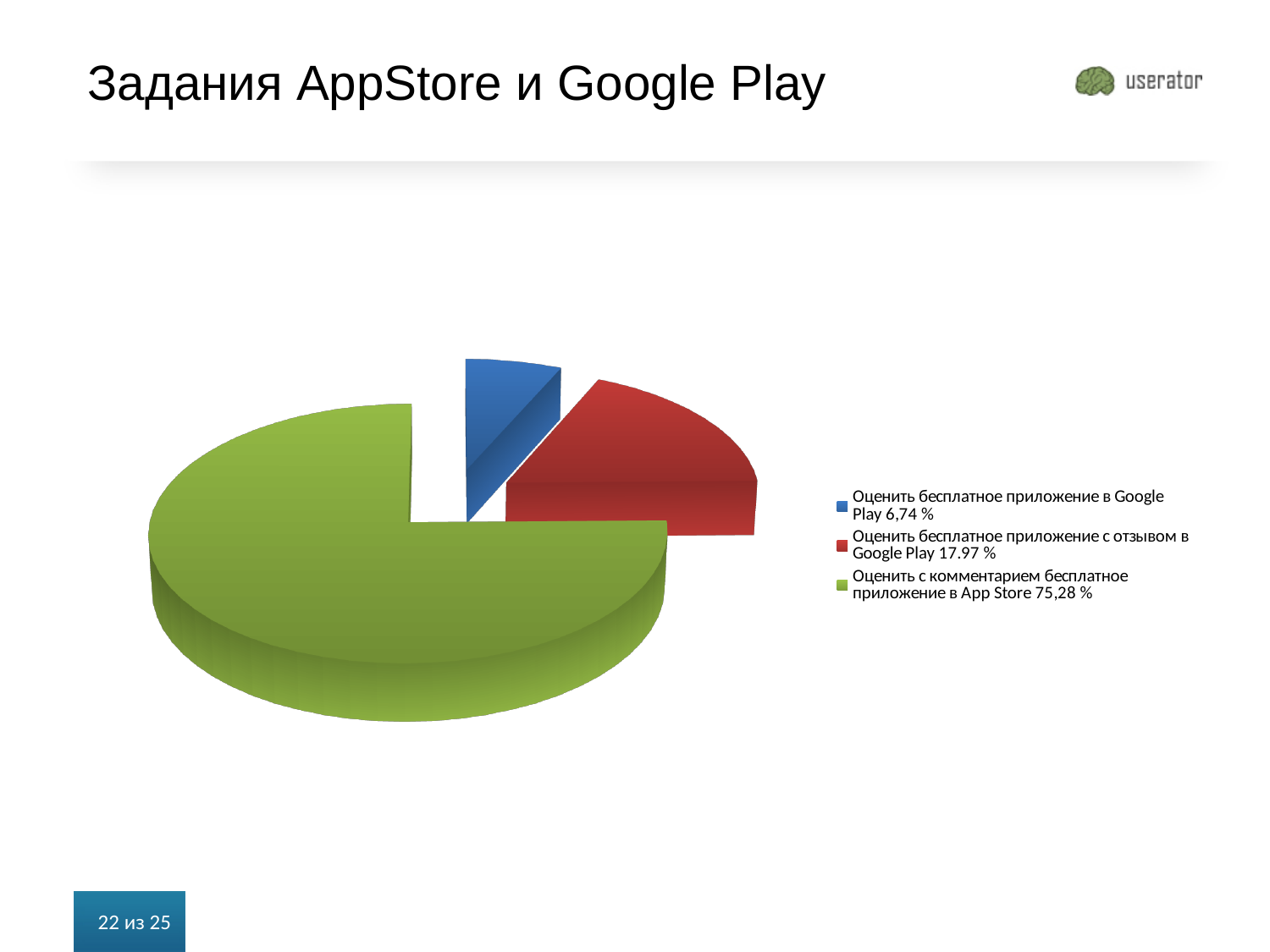
By how many percentage points does the App Store slice exceed the "Оценить бесплатное приложение с отзывом в Google Play" slice? 57.31 How many slices does the pie chart have? 3 What share of the pie is labelled "Оценить с комментарием бесплатное приложение в App Store"? 75,28 % What is the title of the slide containing the pie chart? Задания AppStore и Google Play What share of the pie is labelled "Оценить бесплатное приложение в Google Play"? 6,74 % Which is larger: the share for "Оценить бесплатное приложение с отзывом в Google Play" or for "Оценить бесплатное приложение в Google Play"? Оценить бесплатное приложение с отзывом в Google Play Which category has the largest share of the pie? Оценить с комментарием бесплатное приложение в App Store What colour is the slice for "Оценить с комментарием бесплатное приложение в App Store"? green Which category has the smallest share of the pie? Оценить бесплатное приложение в Google Play What share of the pie is labelled "Оценить бесплатное приложение с отзывом в Google Play"? 17.97 % By how many percentage points does "Оценить бесплатное приложение с отзывом в Google Play" exceed "Оценить бесплатное приложение в Google Play"? 11.23 What kind of chart is shown on the slide? pie chart